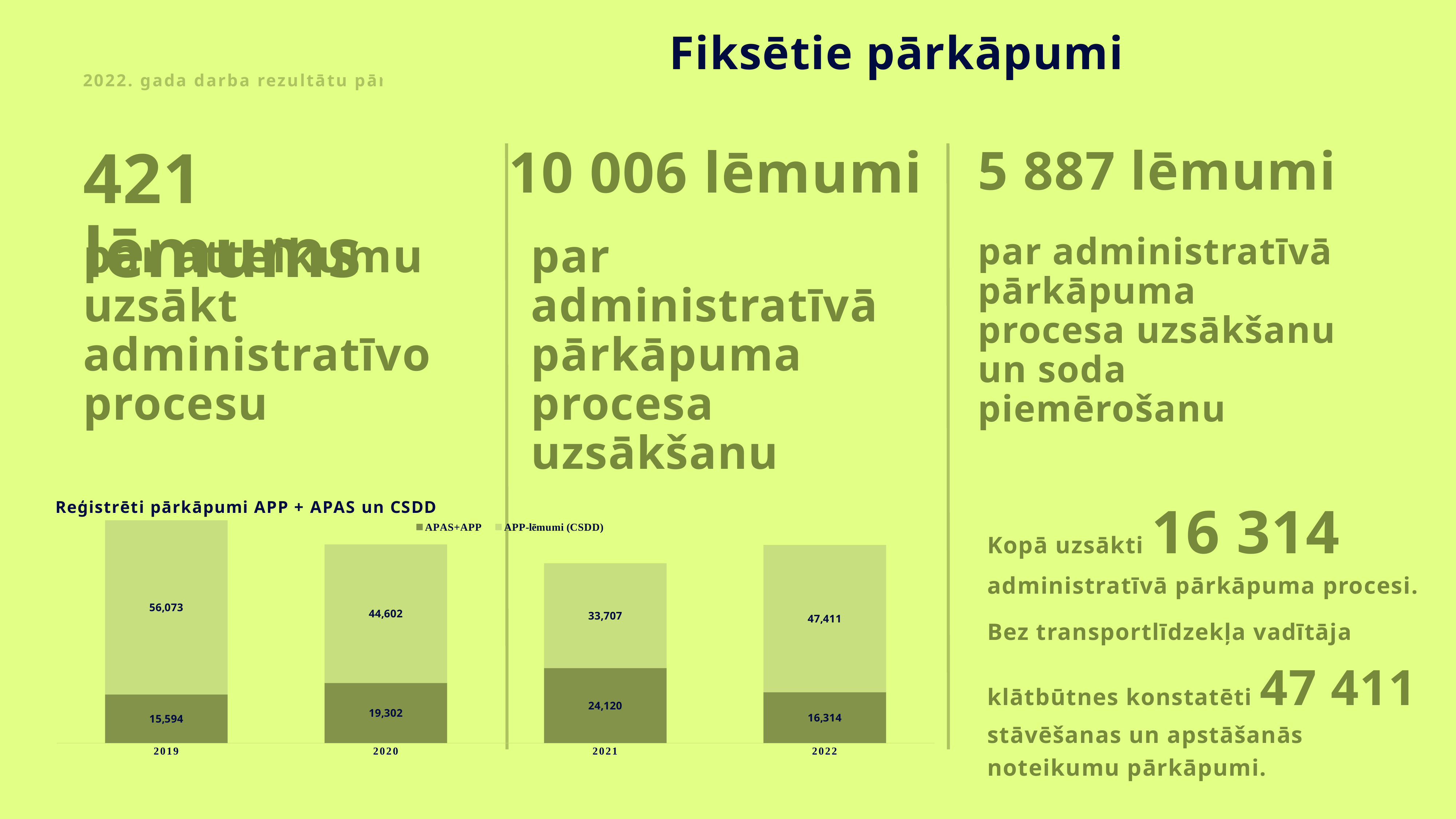
What is the total of the stacked bar for 2022? 63,725 What is the title of the chart? Reģistrēti pārkāpumi APP + APAS un CSDD Which year has the highest APAS+APP value? 2021 Which year has the lowest APP-lēmumi (CSDD) value? 2021 How many years are shown on the x axis of the chart? 4 How many series does the chart legend list? 2 What type of chart is shown on the slide? stacked bar chart What is the difference between the APP-lēmumi (CSDD) values for 2019 and 2020? 11,471 Is the APAS+APP value larger in 2020 or in 2022? 2020 What is the APP-lēmumi (CSDD) value for 2019? 56,073 What is the APP-lēmumi (CSDD) value for 2022? 47,411 What is the APAS+APP value for 2021? 24,120